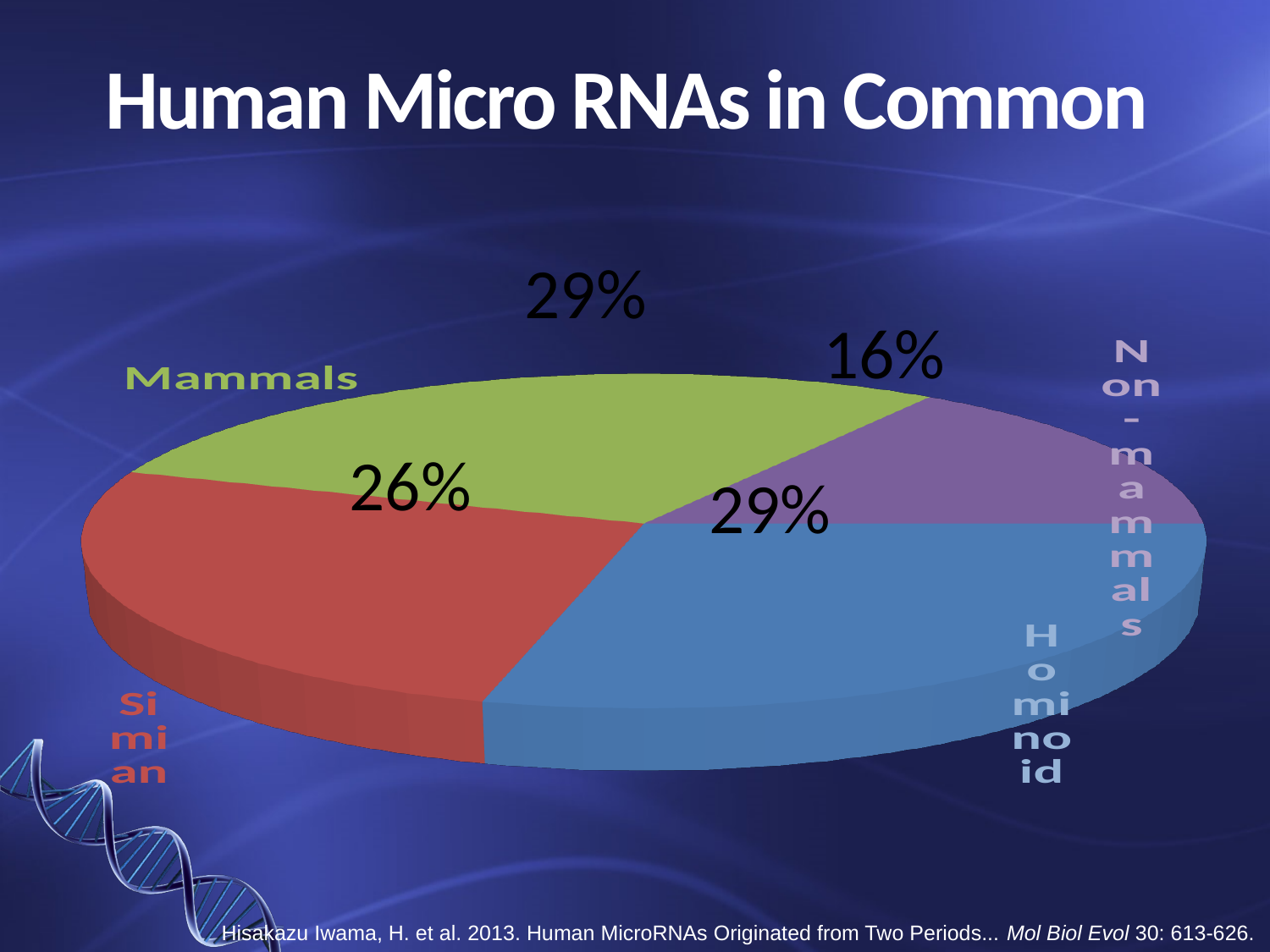
What percentage of the pie is labelled for Mammals? 29% What percentage of the pie is labelled for Non-mammals? 16% Which slice is larger, Simian or Non-mammals? Simian What colour is the Simian slice of the pie? Red What percentage of the pie is labelled for Simian? 26% What is the difference in percentage points between the Mammals slice and the Simian slice? 3 How many slices does the pie chart have? 4 What percentage of the pie is labelled for Hominoid? 29% What is the difference in percentage points between the Simian slice and the Non-mammals slice? 10 What type of chart is shown on the slide? Pie chart What is the title of the chart on the slide? Human Micro RNAs in Common Which category has the smallest slice of the pie? Non-mammals